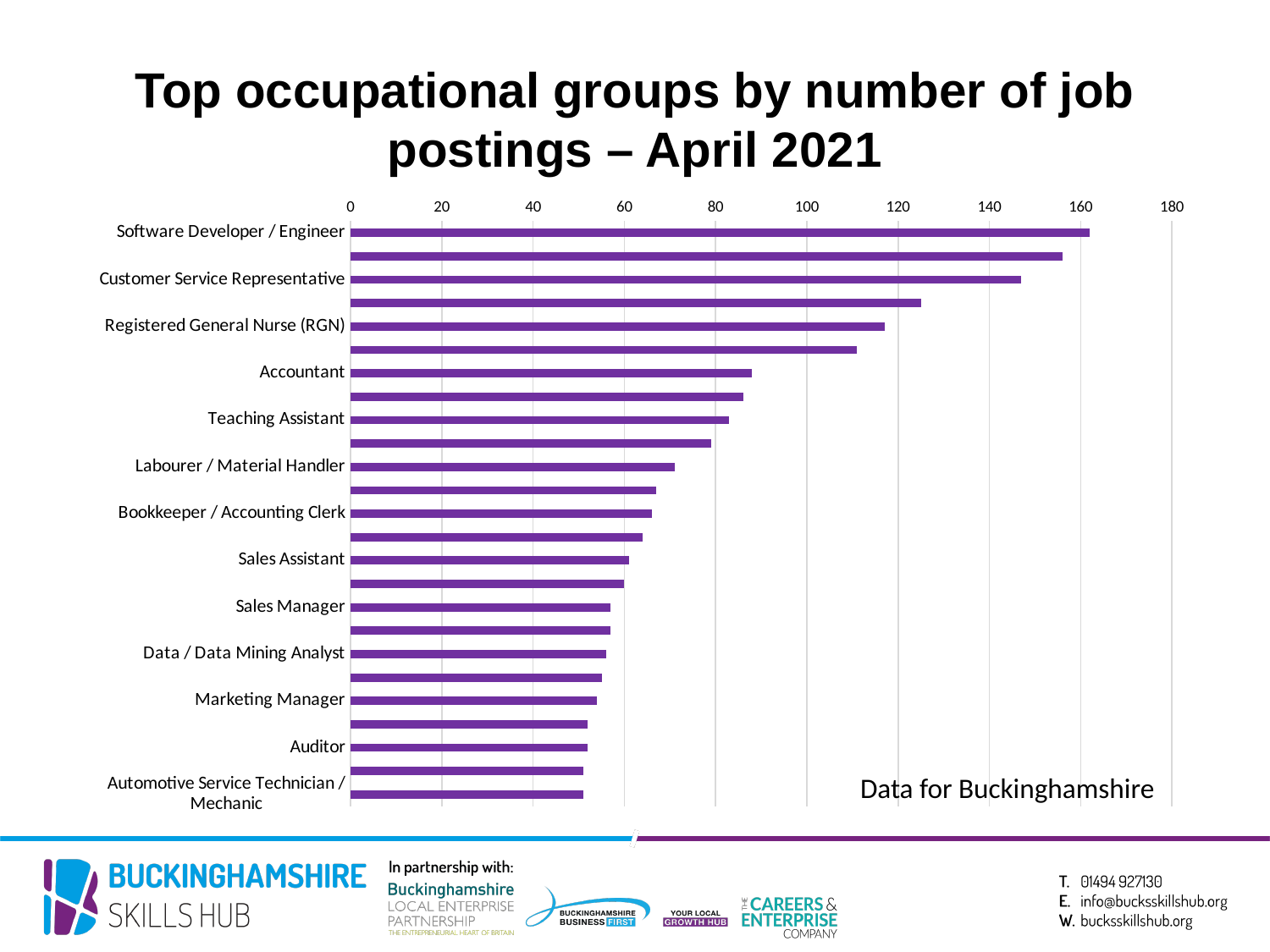
Is the value for Customer Service Representative greater or less than 140? greater Is the value for Accountant greater or less than 100? less Is the value for Software Developer / Engineer greater or less than 140? greater Which occupational group has the highest number of job postings? Software Developer / Engineer Which has more job postings, Accountant or Sales Manager? Accountant What is the title of the chart? Top occupational groups by number of job postings – April 2021 Do the bar lengths increase or decrease going from the top of the chart to the bottom? decrease Which has more job postings, Registered General Nurse (RGN) or Teaching Assistant? Registered General Nurse (RGN) What kind of chart is shown on the slide? bar chart